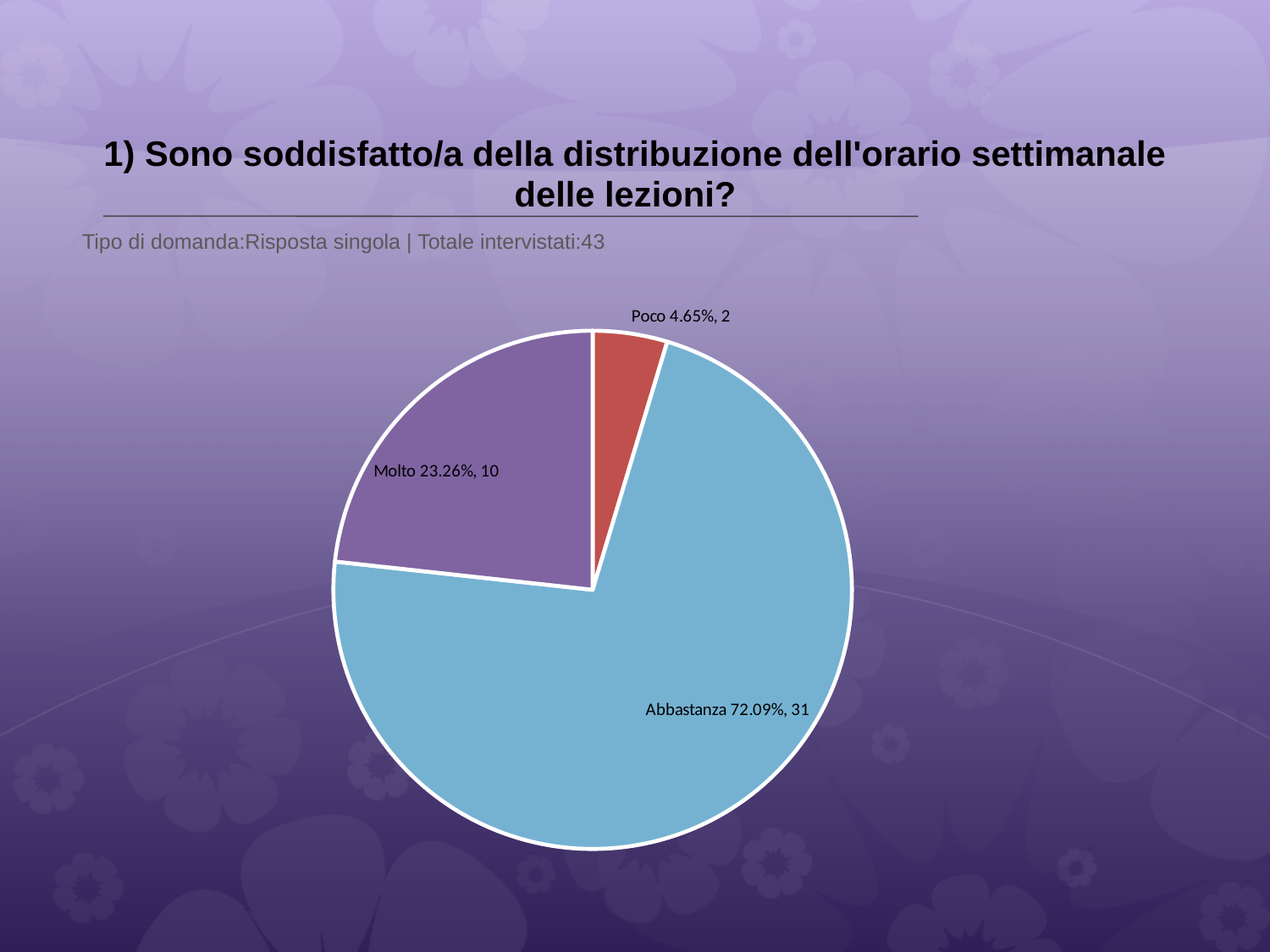
Which response has more respondents, "Molto" or "Poco"? Molto How many slices does the pie chart have? 3 What percentage of respondents answered "Poco"? 4.65% How many respondents answered "Poco"? 2 What is the difference in the number of respondents between "Abbastanza" and "Molto"? 21 What percentage of respondents answered "Abbastanza"? 72.09% What is the total number of respondents across all three slices? 43 How many respondents answered "Molto"? 10 Which response has the smallest share of the pie? Poco What colour is the "Abbastanza" slice? light blue What kind of chart is shown on the slide? pie chart Which response has the largest share of the pie? Abbastanza